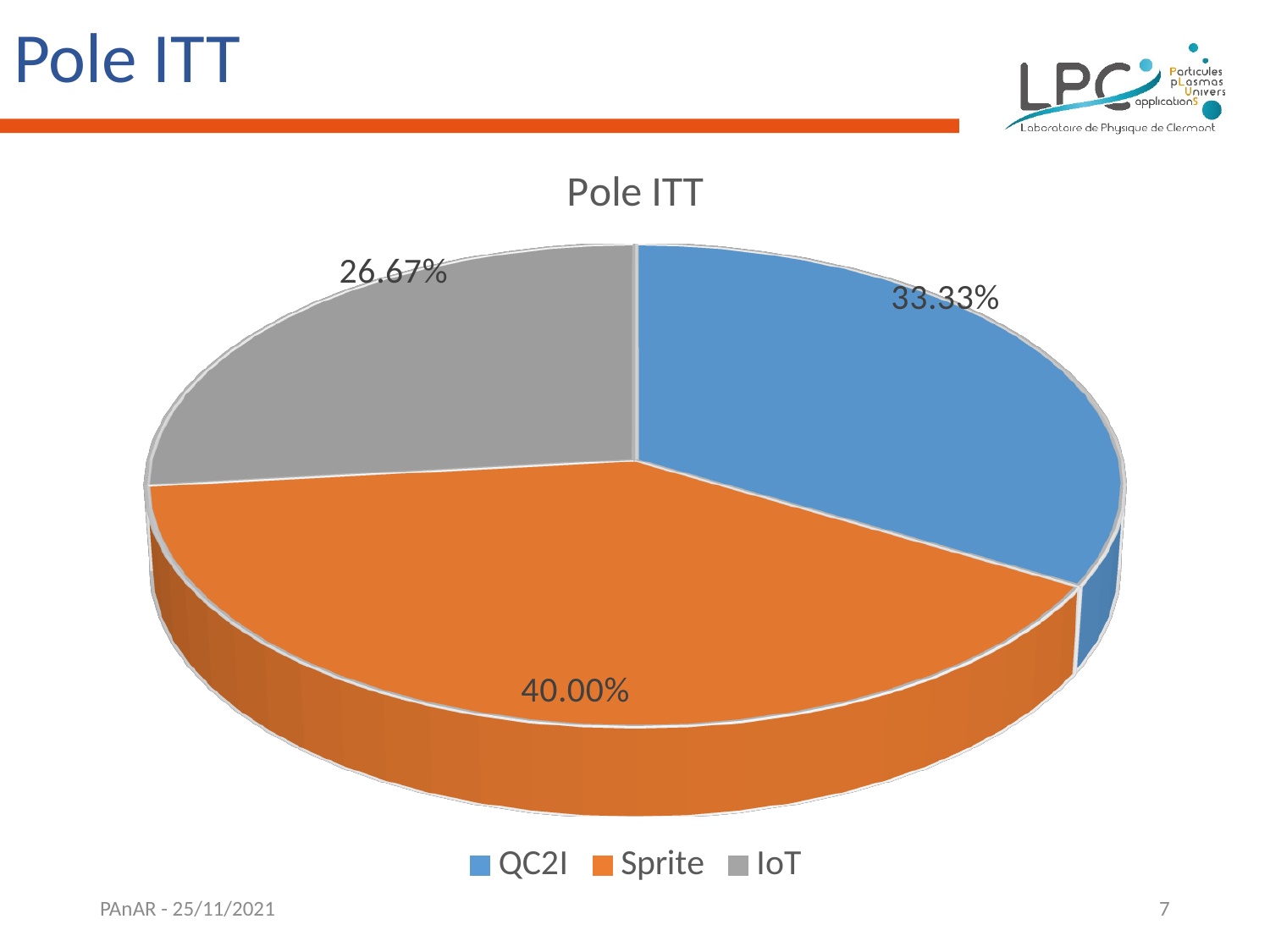
Which category has the largest slice? Sprite Which is larger, the share for QC2I or the share for IoT? QC2I What is the title of the chart? Pole ITT How many entries does the legend list? 3 What share of the pie does IoT represent? 26.67% Which category has the smallest slice? IoT What share of the pie does Sprite represent? 40.00% Which colour represents Sprite in the chart? orange What is the difference between the share for Sprite and the share for IoT? 13.33% What kind of chart is shown on the slide? pie chart What share of the pie does QC2I represent? 33.33% How many slices does the pie chart have? 3